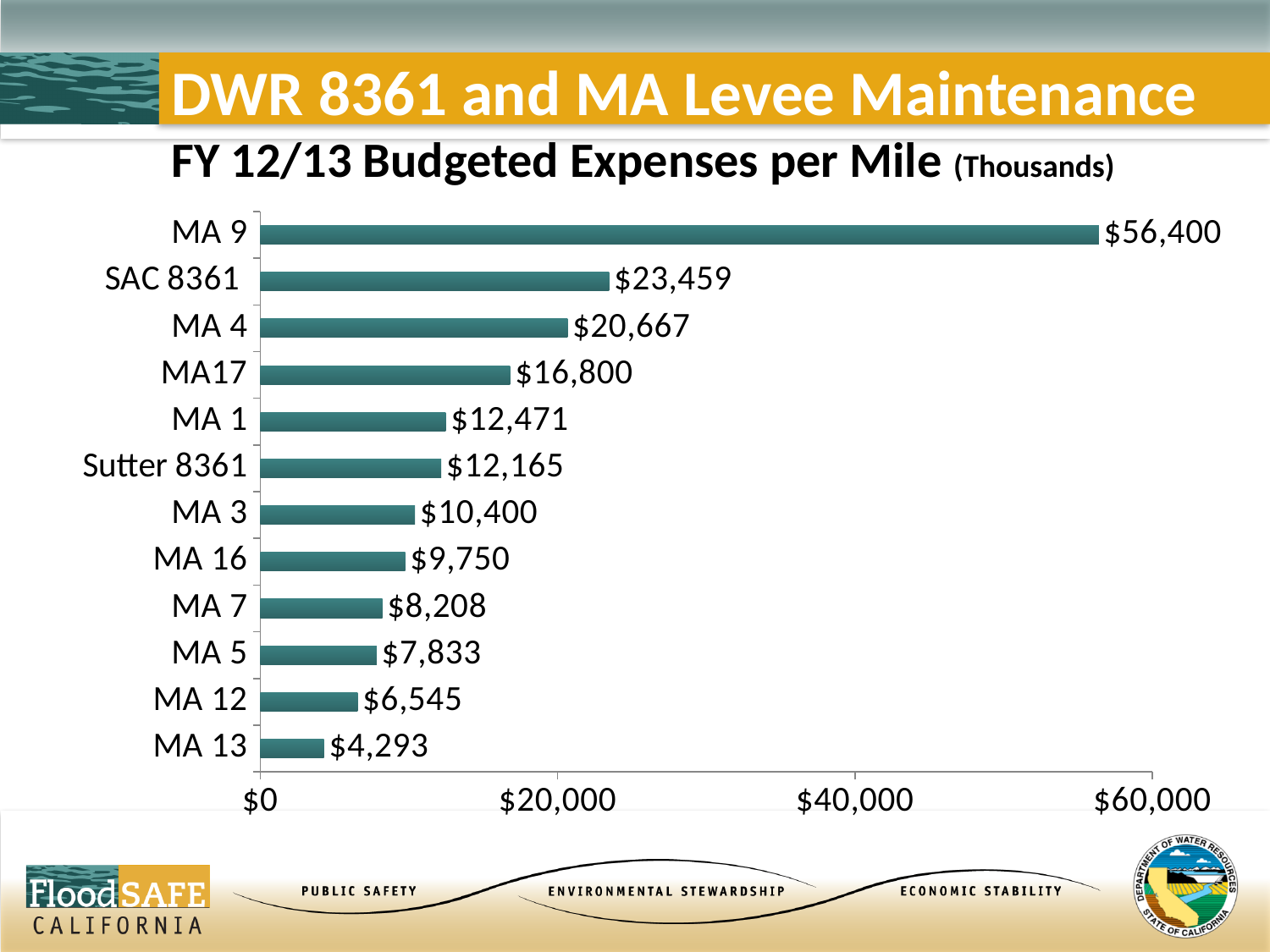
What is the difference between the values for MA 9 and SAC 8361? $32,941 What kind of chart is shown on the slide? Bar chart Which category has the highest budgeted expense per mile? MA 9 What is the budgeted expense per mile for MA 9? $56,400 What is the budgeted expense per mile for SAC 8361? $23,459 Which has a larger budgeted expense per mile, MA 3 or MA 16? MA 3 How many categories are shown in the chart? 12 What is the difference between the values for MA 4 and MA17? $3,867 Which category has the lowest budgeted expense per mile? MA 13 Is the value for MA 9 greater or less than $40,000? greater What is the budgeted expense per mile for Sutter 8361? $12,165 What is the budgeted expense per mile for MA 13? $4,293